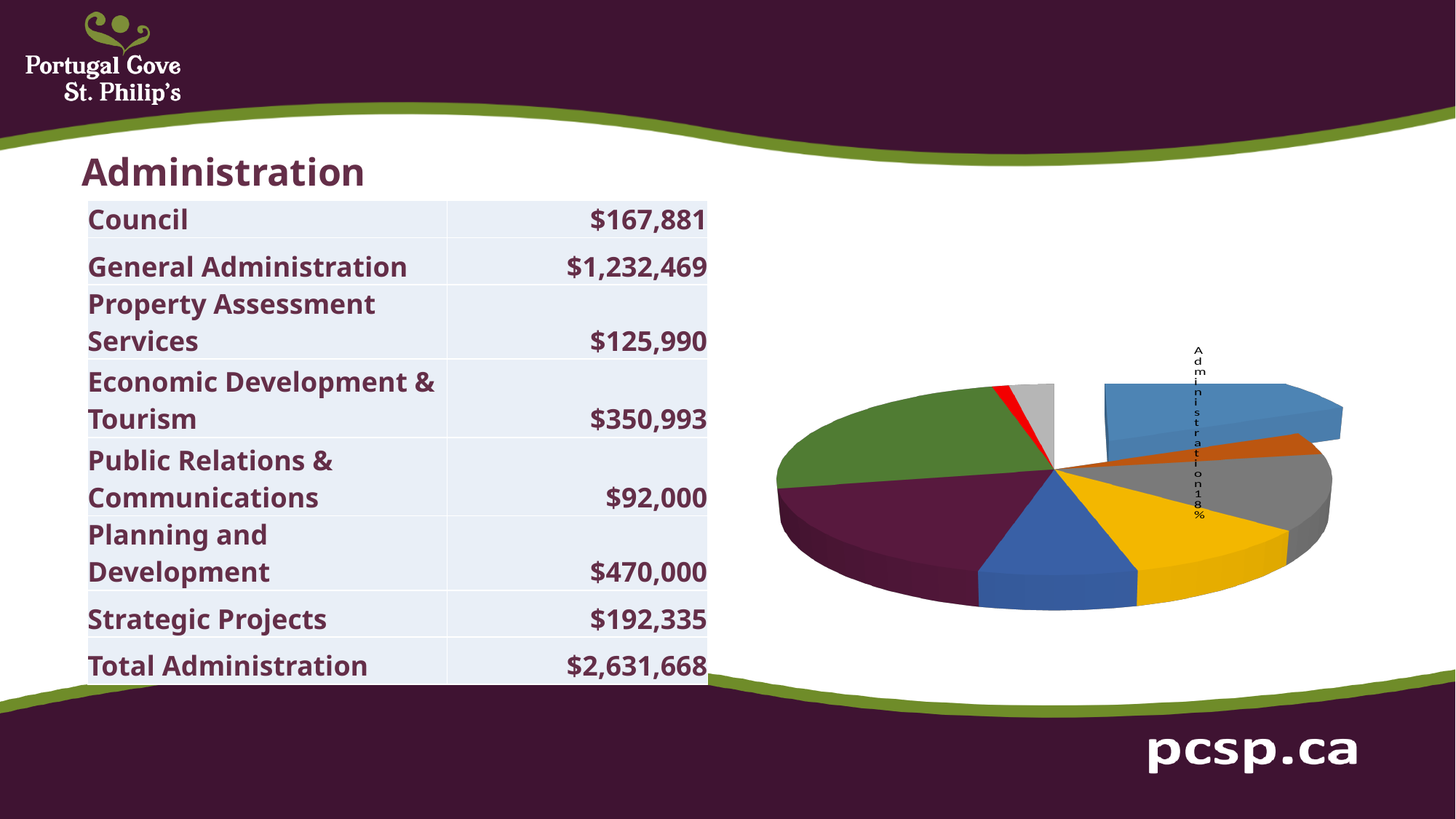
Does the pie chart include a legend? No Which slice of the pie chart is pulled out (exploded) from the rest? Administration (the blue slice) Which is larger in the pie chart, the yellow slice or the red slice? the yellow slice What kind of chart is shown on the right of the slide? pie chart How many slices does the pie chart have? 9 Which slice of the pie chart is the smallest? the red slice What share of the pie does the Administration slice represent? 18% Which is larger in the pie chart, the green slice or the red slice? the green slice